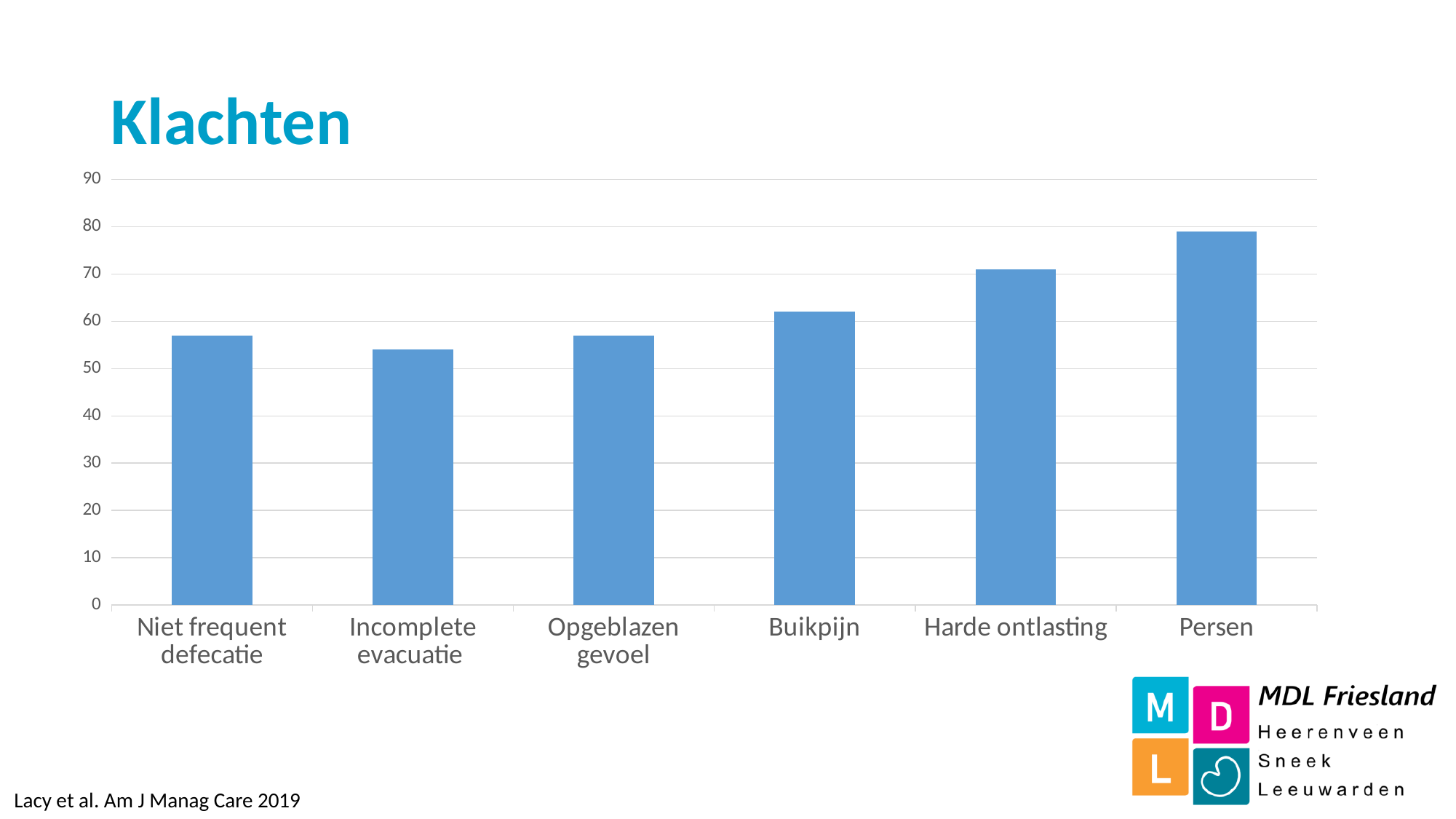
Is the value for Incomplete evacuatie greater or less than 50? greater Which category has the highest value? Persen Is the value for Buikpijn greater or less than 70? less Is the value for Harde ontlasting greater or less than 60? greater Which category has the lowest value? Incomplete evacuatie Which is larger, the value for Harde ontlasting or the value for Incomplete evacuatie? Harde ontlasting What kind of chart is shown on the slide? bar chart Which is larger, the value for Persen or the value for Buikpijn? Persen How many categories are shown on the x axis of the chart? 6 What is the title of the chart? Klachten